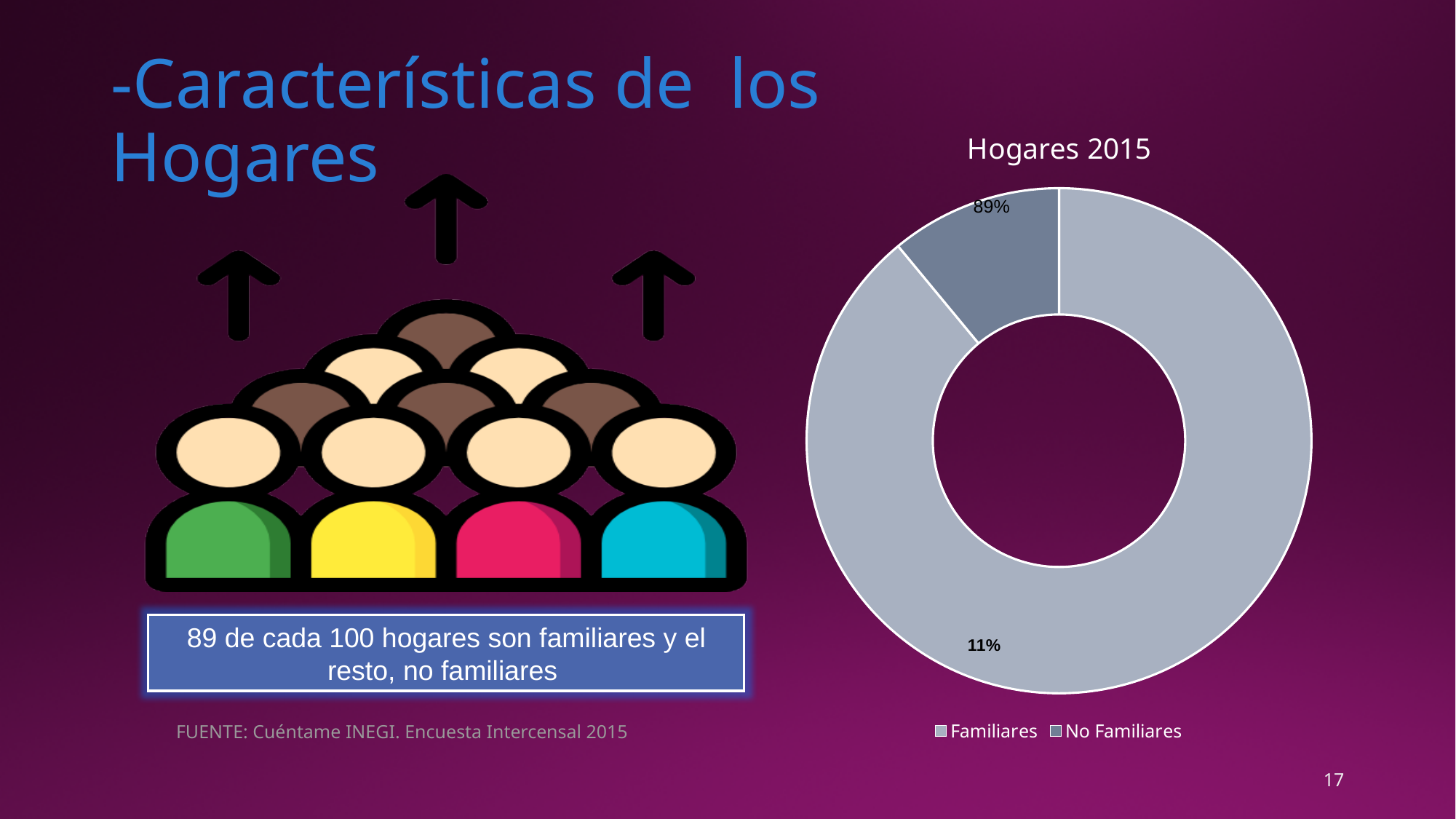
Which category takes up the smallest share of the doughnut chart? No Familiares Which category takes up the largest share of the doughnut chart? Familiares Is the share of the Familiares slice greater or less than 50%? greater Is the share of the No Familiares slice greater or less than 25%? less Which slice is larger, Familiares or No Familiares? Familiares What are the two legend entries of the chart? Familiares and No Familiares How many slices does the doughnut chart have? 2 What kind of chart is shown on the slide? doughnut chart Which two percentage labels are printed on the doughnut chart? 89% and 11% How many categories does the chart's legend list? 2 What is the title of the chart on the slide? Hogares 2015